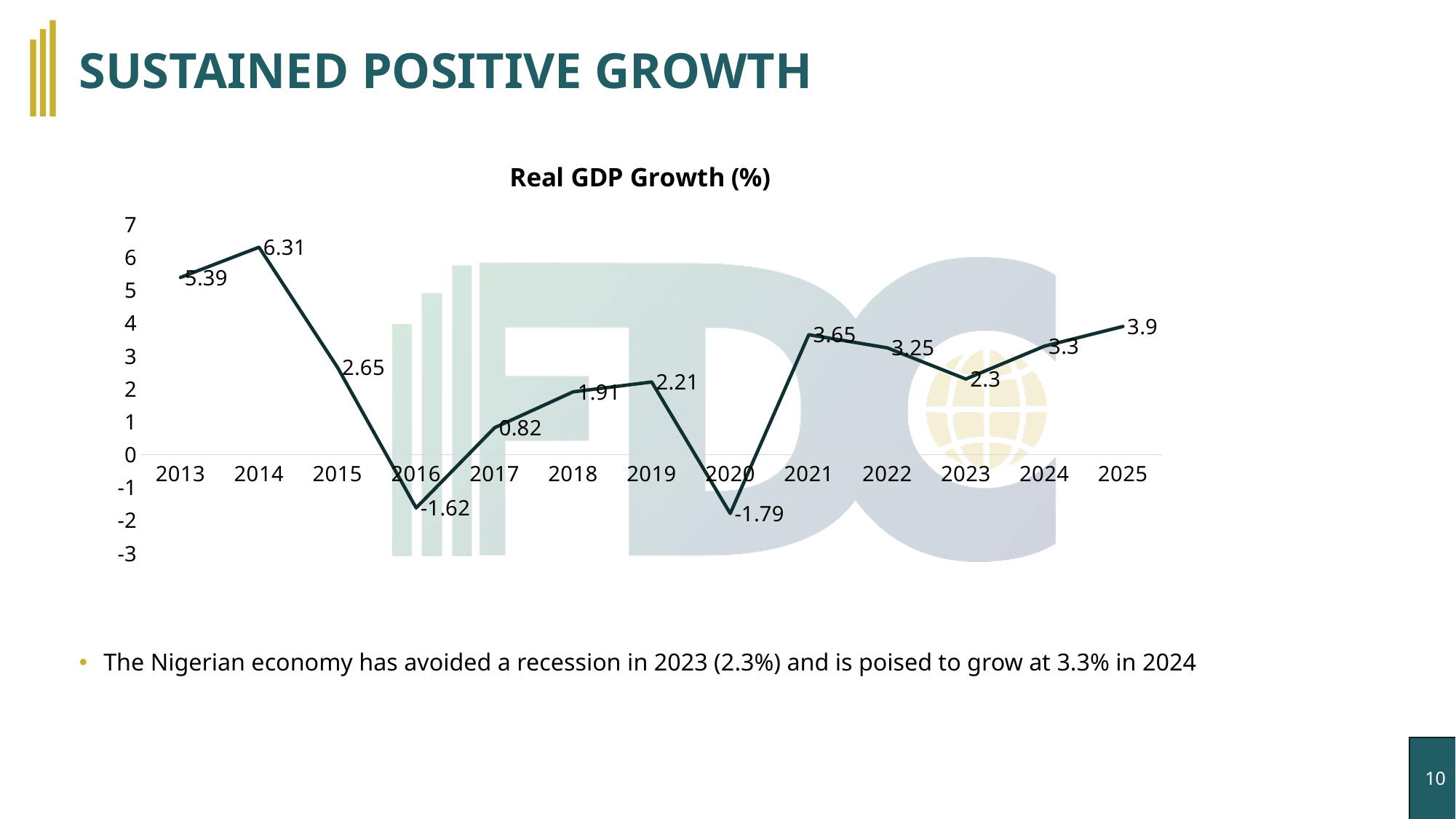
What is the difference between the Real GDP Growth (%) values for 2024 and 2023? 1 What is the Real GDP Growth (%) value for 2014? 6.31 What kind of chart is shown on the slide? Line chart Does Real GDP Growth (%) rise or fall from 2023 to 2025? Rise How many years on the chart show a negative Real GDP Growth (%) value? 2 Which year has the lowest Real GDP Growth (%)? 2020 What is the Real GDP Growth (%) value for 2025? 3.9 What is the Real GDP Growth (%) value for 2020? -1.79 What is the title of the chart? Real GDP Growth (%) How many years are plotted on the Real GDP Growth (%) chart? 13 Which year has a higher Real GDP Growth (%), 2021 or 2022? 2021 Which year has the highest Real GDP Growth (%)? 2014